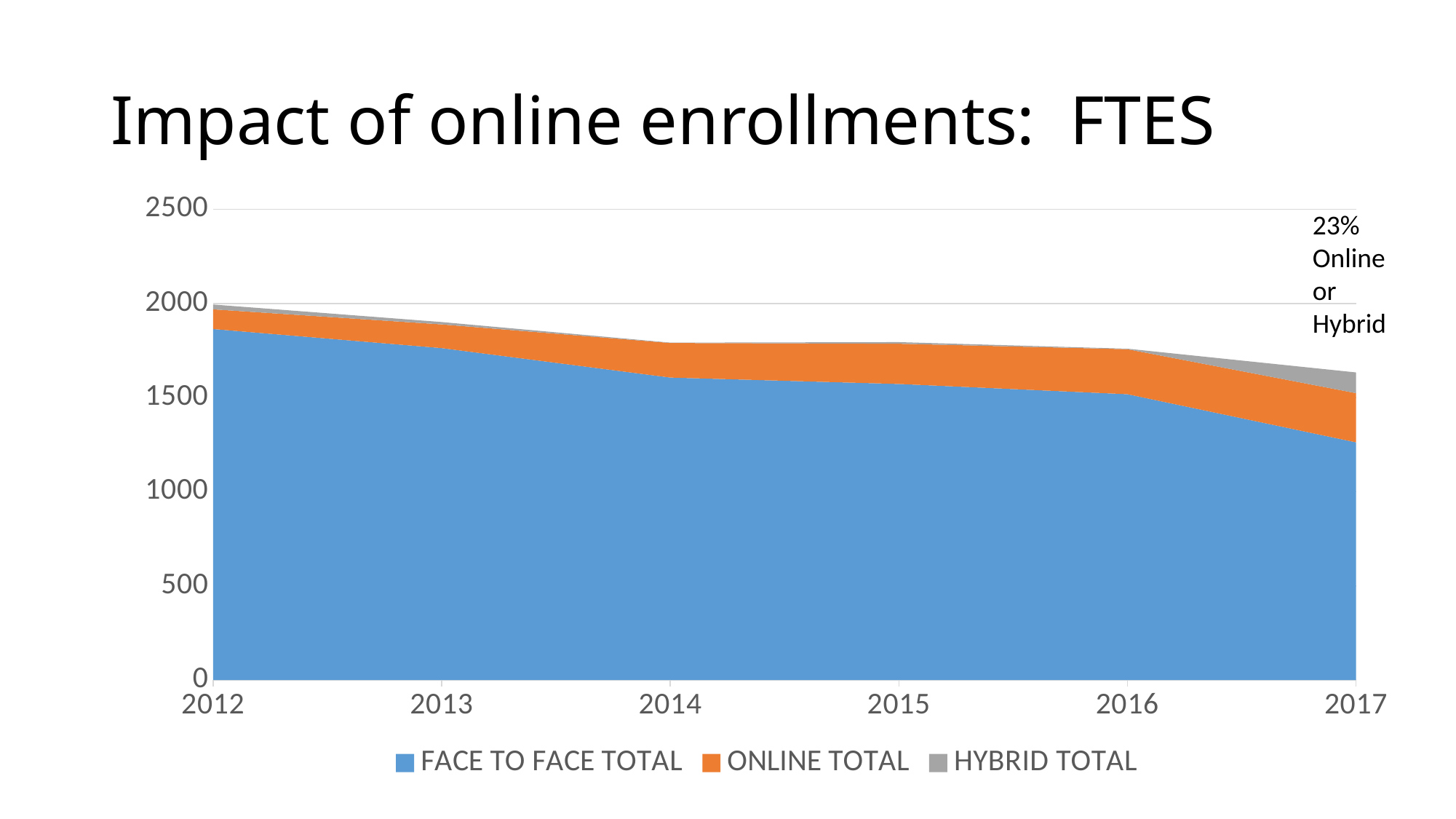
Is the FACE TO FACE TOTAL value for 2012 greater or less than 1500? greater What kind of chart is shown on the slide? Stacked area chart Which series is shown in orange? ONLINE TOTAL How many years are shown on the x axis? 6 Is the FACE TO FACE TOTAL value for 2017 greater or less than 1500? less What is the title of the slide? Impact of online enrollments: FTES Is the combined total of all three series in 2017 greater or less than 1500? greater How many series does the legend list? 3 In which year is the FACE TO FACE TOTAL lowest? 2017 In which year is the FACE TO FACE TOTAL highest? 2012 Does the FACE TO FACE TOTAL rise or fall from 2012 to 2017? Fall